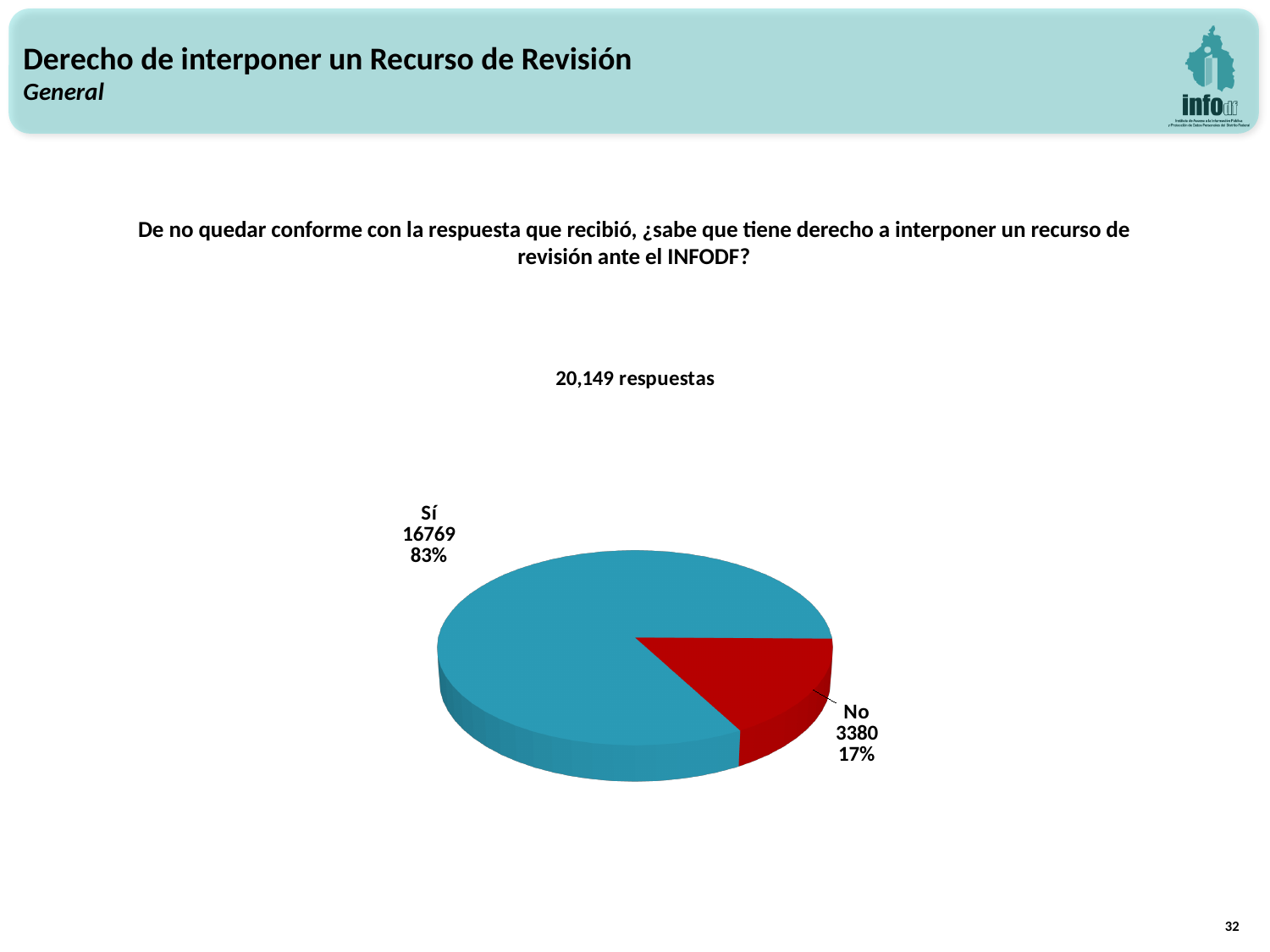
Which has more responses, "Sí" or "No"? Sí How many slices does the pie chart have? 2 What is the number of responses for "Sí"? 16769 What is the number of responses for "No"? 3380 What colour is the "No" slice? red What share of the pie does the "Sí" slice represent? 83% What kind of chart is shown on the slide? pie chart What is the difference between the number of "Sí" and "No" responses? 13389 Which slice is the smallest? No What is the total number of responses shown above the chart? 20,149 respuestas What share of the pie does the "No" slice represent? 17% Which slice is the largest? Sí